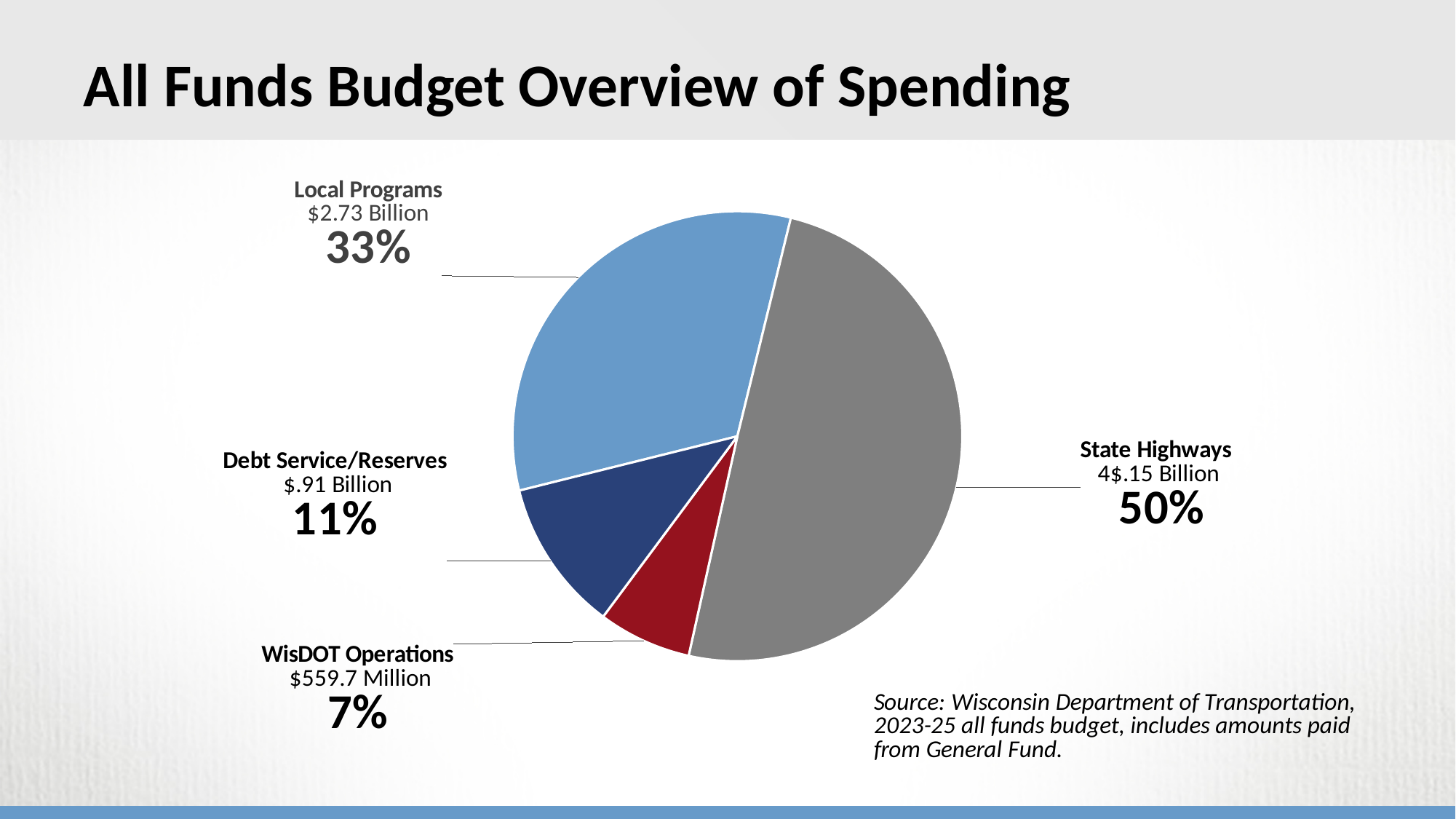
Which category has the largest share of spending? State Highways What is the difference in percentage points between the State Highways share and the Local Programs share? 17 percentage points What share of spending goes to Debt Service/Reserves? 11% What share of spending goes to State Highways? 50% What kind of chart is shown on the slide? pie chart What share of spending goes to Local Programs? 33% How many categories are shown in the pie chart? 4 Which category has the smallest share of spending? WisDOT Operations What is the dollar amount shown for Local Programs? $2.73 Billion What is the dollar amount shown for WisDOT Operations? $559.7 Million What is the dollar amount shown for Debt Service/Reserves? $.91 Billion